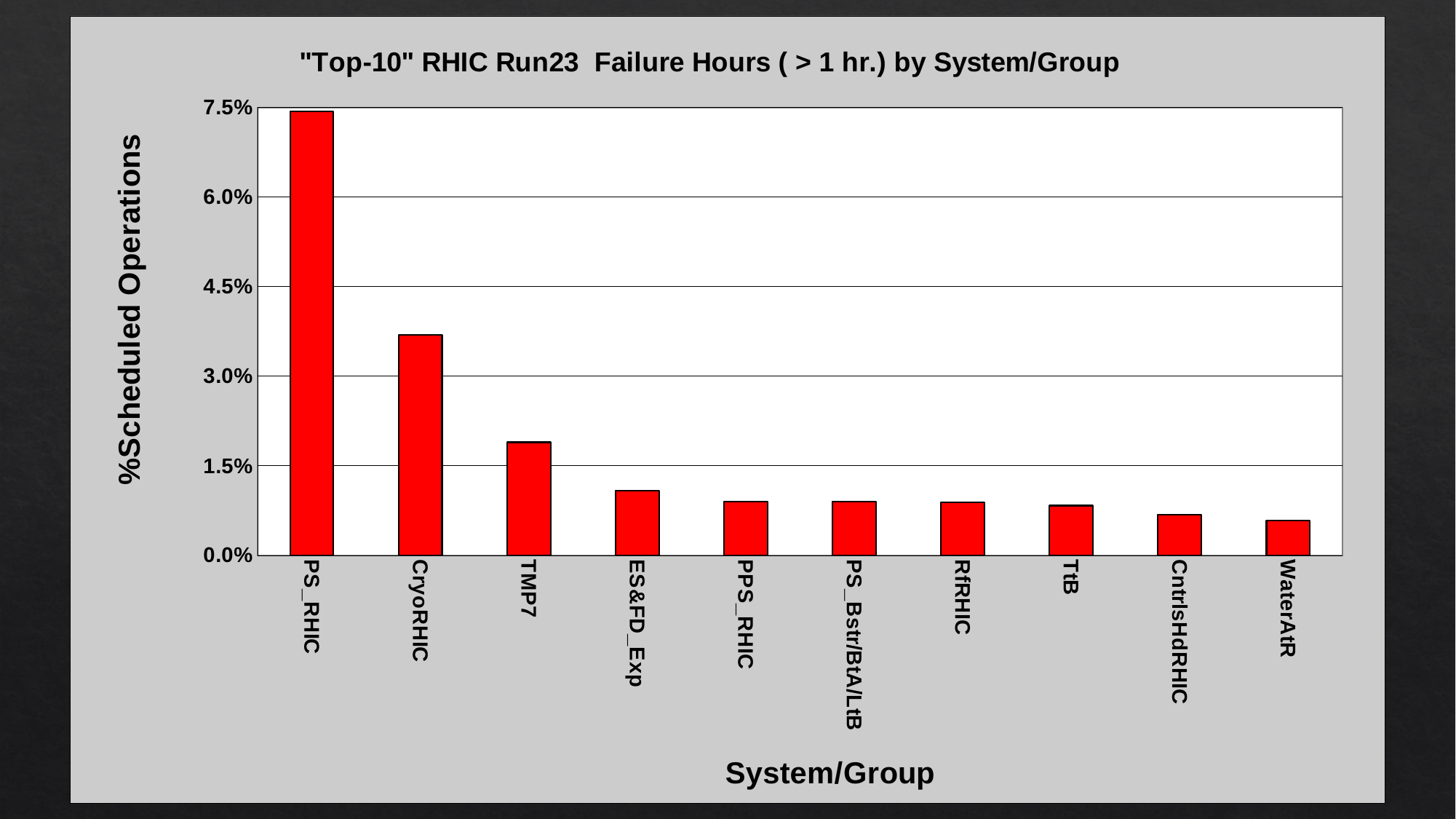
Is the value for TMP7 greater or less than 1.5%? greater Is the value for CryoRHIC greater or less than 4.5%? less Which has a larger value, CryoRHIC or TMP7? CryoRHIC Do the bar values rise or fall moving from left to right along the x axis? fall What is the label of the y axis? %Scheduled Operations What kind of chart is shown on the slide? bar chart Which system/group has the lowest bar on the chart? WaterAtR Is the value for CryoRHIC greater or less than 3.0%? greater Which system/group has the highest percentage of scheduled operations lost to failures? PS_RHIC How many systems/groups are plotted on the chart? 10